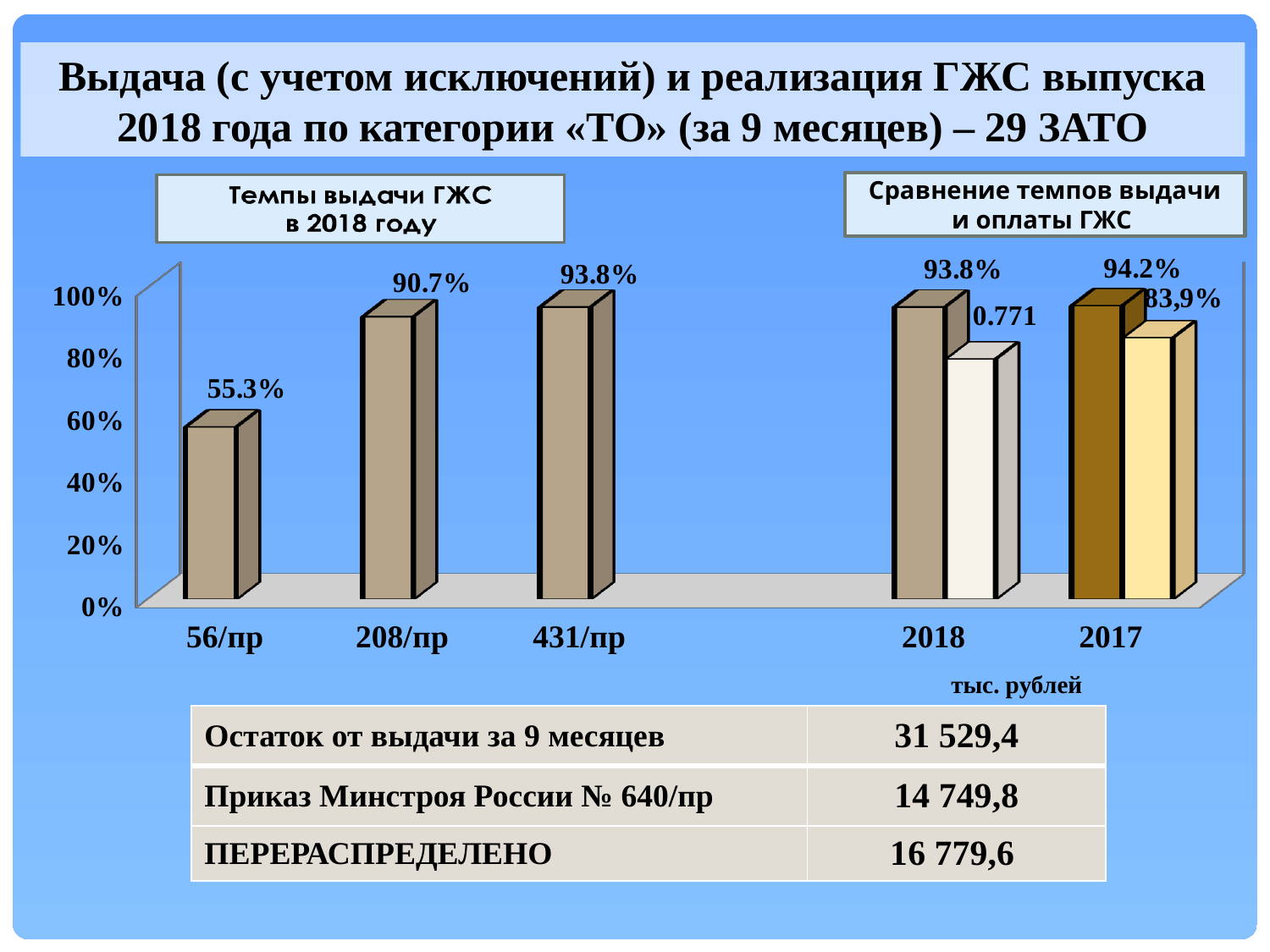
In the 'Темпы выдачи ГЖС в 2018 году' section, which category has the highest value? 431/пр In the 'Темпы выдачи ГЖС в 2018 году' section, what is the value for 208/пр? 90.7% In the 'Сравнение темпов выдачи и оплаты ГЖС' section, what is the label on the second (lighter) bar for 2018? 0.771 In the 'Темпы выдачи ГЖС в 2018 году' section, what is the value for 431/пр? 93.8% In the 'Темпы выдачи ГЖС в 2018 году' section, which is larger: the value for 208/пр or the value for 56/пр? 208/пр In the 'Темпы выдачи ГЖС в 2018 году' section, what is the difference between the values for 431/пр and 56/пр? 38.5 percentage points In the 'Темпы выдачи ГЖС в 2018 году' section, which category has the lowest value? 56/пр What kind of chart is shown on the slide? Bar chart In the 'Темпы выдачи ГЖС в 2018 году' section, what is the value for 56/пр? 55.3% In the 'Сравнение темпов выдачи и оплаты ГЖС' section, what is the label on the first (darker) bar for 2017? 94.2% How many categories are shown in the 'Темпы выдачи ГЖС в 2018 году' section? 3 In the 'Сравнение темпов выдачи и оплаты ГЖС' section, what is the label on the second (lighter) bar for 2017? 83,9%